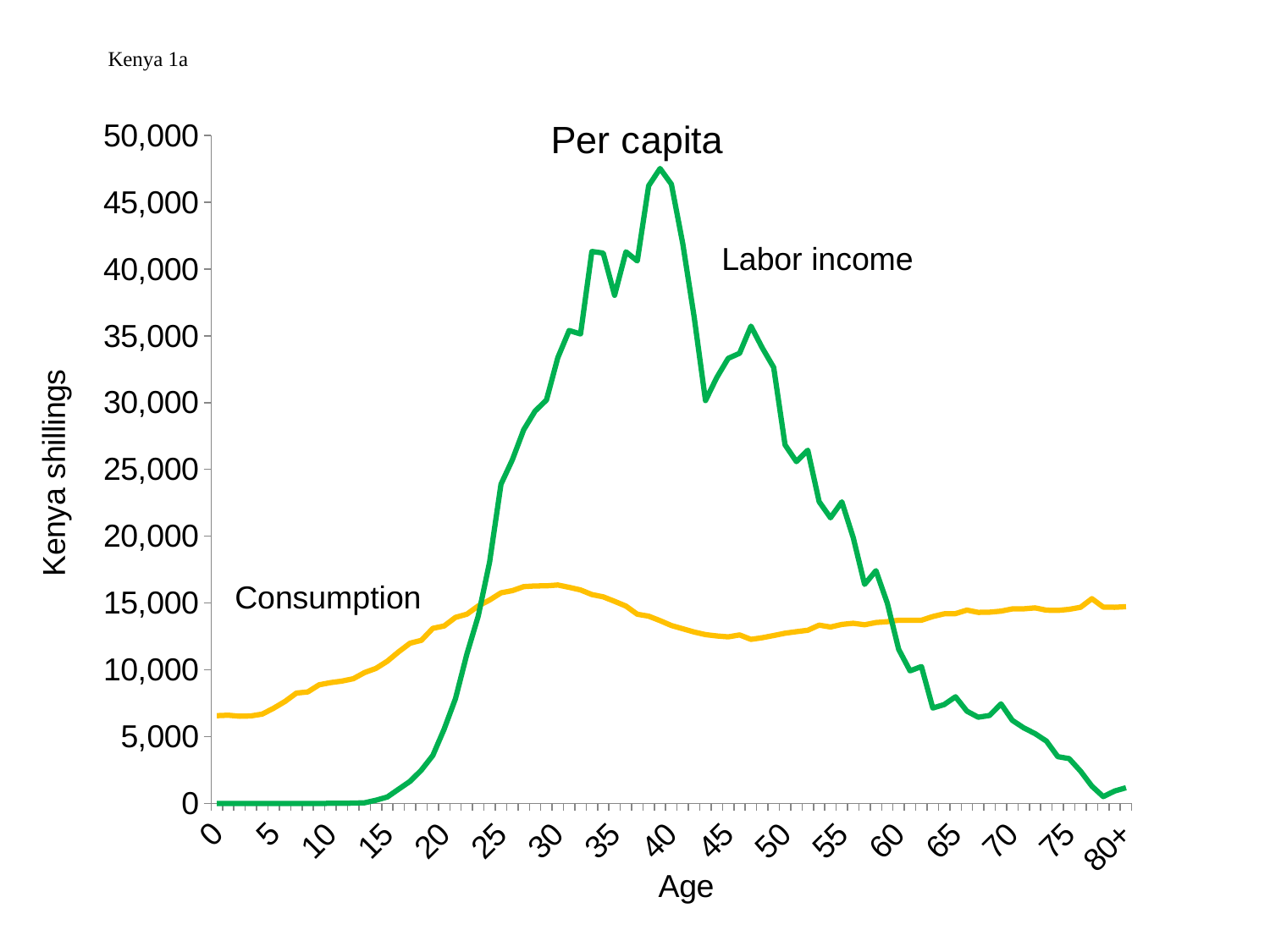
Is the value of Labor income at age 40 greater or less than 45,000? greater What kind of chart is shown on the slide? line chart Is the value of Labor income at age 65 greater or less than 10,000? less What is the label on the vertical axis of the chart? Kenya shillings At age 70, which series has the larger value, Labor income or Consumption? Consumption Is the value of Labor income at age 10 greater or less than 5,000? less What is the title of the chart? Per capita How many data series are plotted on the chart? 2 At age 40, which series has the larger value, Labor income or Consumption? Labor income Does Consumption rise or fall between age 0 and age 30? rise